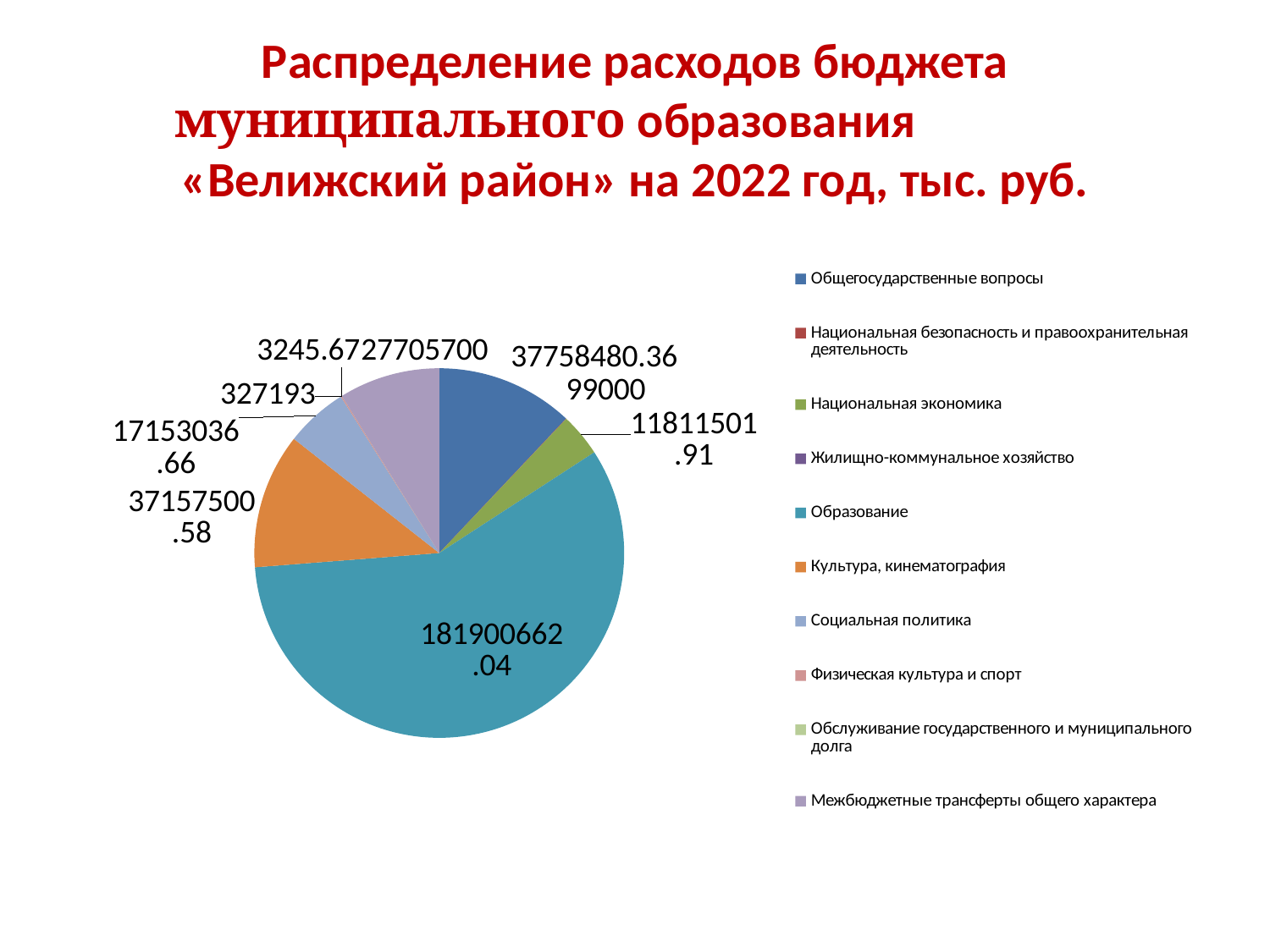
What is the value shown for Национальная экономика? 11811501.91 What kind of chart is shown on the slide? pie chart What is the difference between the values for Общегосударственные вопросы and Культура, кинематография? 600979.78 How many categories does the legend of the pie chart list? 10 What is the value shown for Социальная политика? 17153036.66 What colour is the slice for Образование in the pie chart? teal Which is larger, the value for Образование or the value for Культура, кинематография? Образование What is the value shown for Общегосударственные вопросы? 37758480.36 Which category has the largest slice of the pie chart? Образование What is the value shown for Образование? 181900662.04 What is the value shown for Культура, кинематография? 37157500.58 Which is larger, the value for Общегосударственные вопросы or the value for Национальная экономика? Общегосударственные вопросы